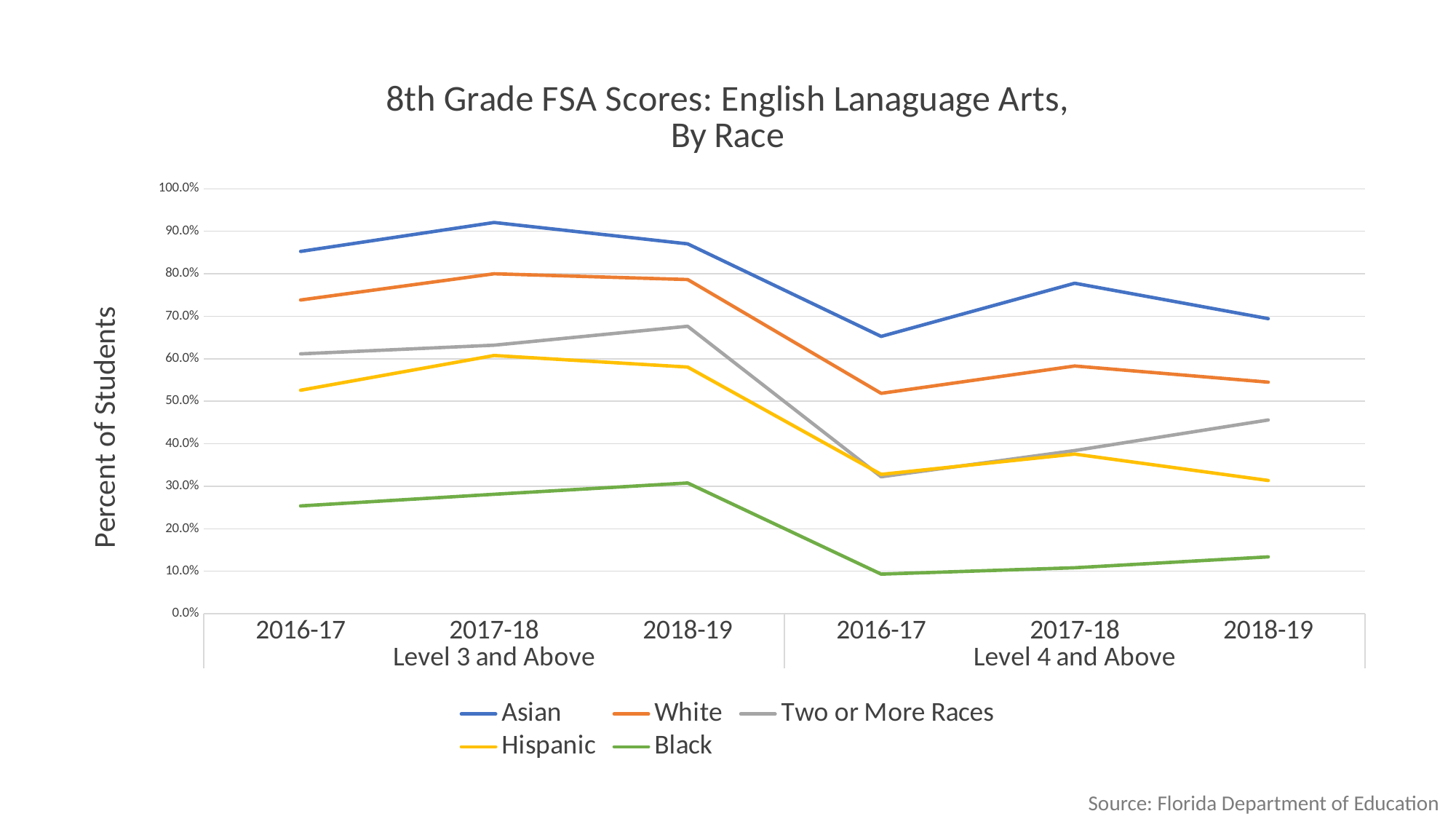
Is the value for Asian at 2017-18 under Level 3 and Above greater or less than 90.0%? greater At 2018-19 under Level 4 and Above, which is larger: Two or More Races or Hispanic? Two or More Races What is the y-axis title of the chart? Percent of Students Is the value for White at 2016-17 under Level 4 and Above greater or less than 50.0%? greater What kind of chart is shown on the slide? line chart Do the values for Black rise or fall from 2016-17 to 2018-19 under Level 3 and Above? rise What source is cited for the chart? Florida Department of Education Which series has the highest value at 2017-18 under Level 3 and Above? Asian How many series does the legend list? 5 Which series has the lowest value at 2016-17 under Level 4 and Above? Black How many points are there along the x axis? 6